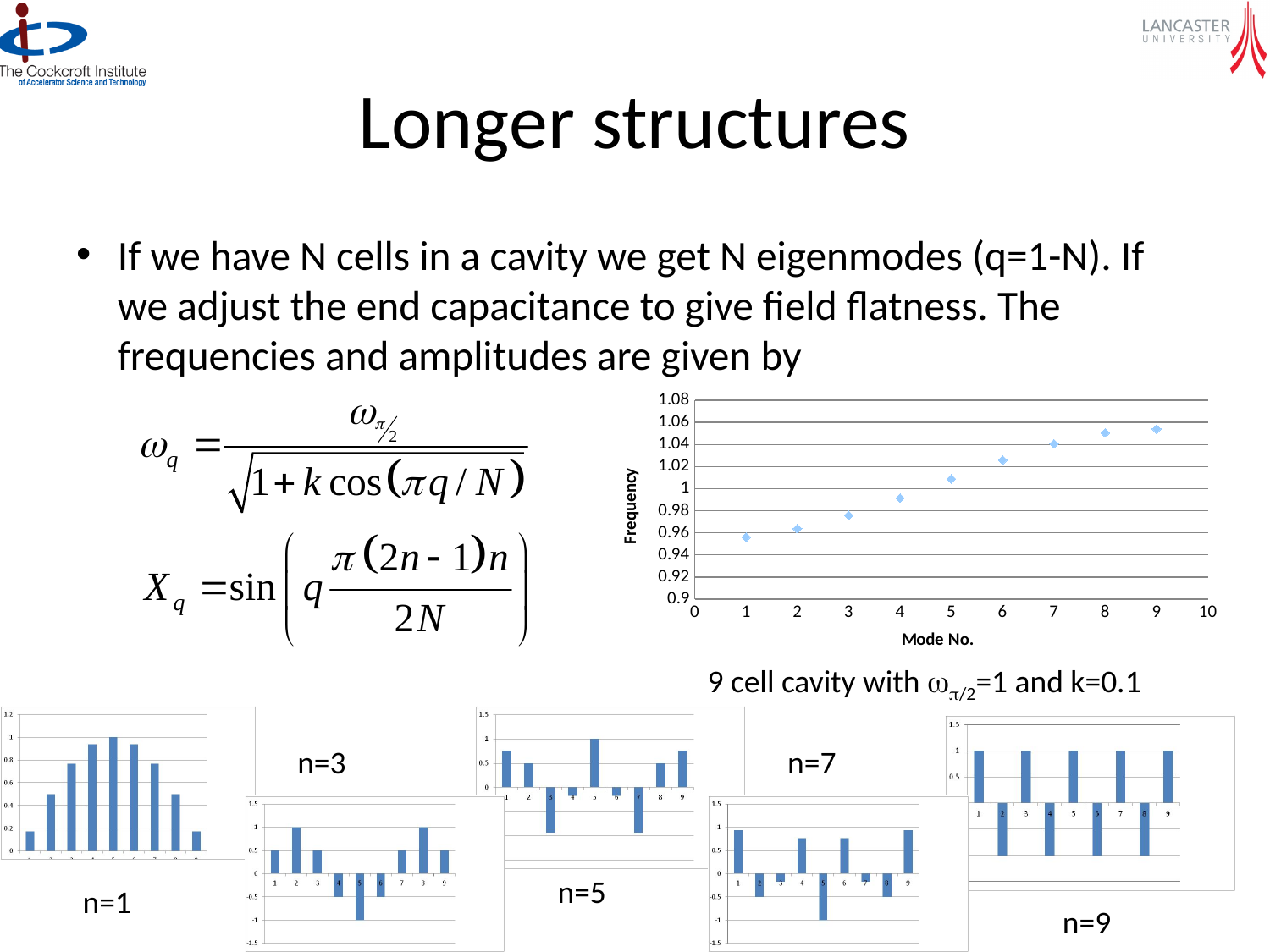
In the n=1 chart at the bottom left, how many bars are there? 9 In the Frequency vs Mode No. chart, which mode number has the lowest frequency? 1 In the Frequency vs Mode No. chart, how many data points are plotted? 9 In the n=1 chart at the bottom left, what kind of chart is it? bar chart In the Frequency vs Mode No. chart, is the frequency for mode 2 greater or less than 0.98? less In the Frequency vs Mode No. chart, what is the label on the horizontal axis? Mode No. In the Frequency vs Mode No. chart, is the frequency for mode 6 greater or less than 1? greater In the Frequency vs Mode No. chart, which has the larger frequency, mode 8 or mode 2? mode 8 In the Frequency vs Mode No. chart, is the frequency for mode 9 greater or less than 1.04? greater In the Frequency vs Mode No. chart, which mode number has the highest frequency? 9 In the Frequency vs Mode No. chart, what kind of chart is it? scatter chart In the Frequency vs Mode No. chart, does the frequency rise or fall as the mode number increases? rise